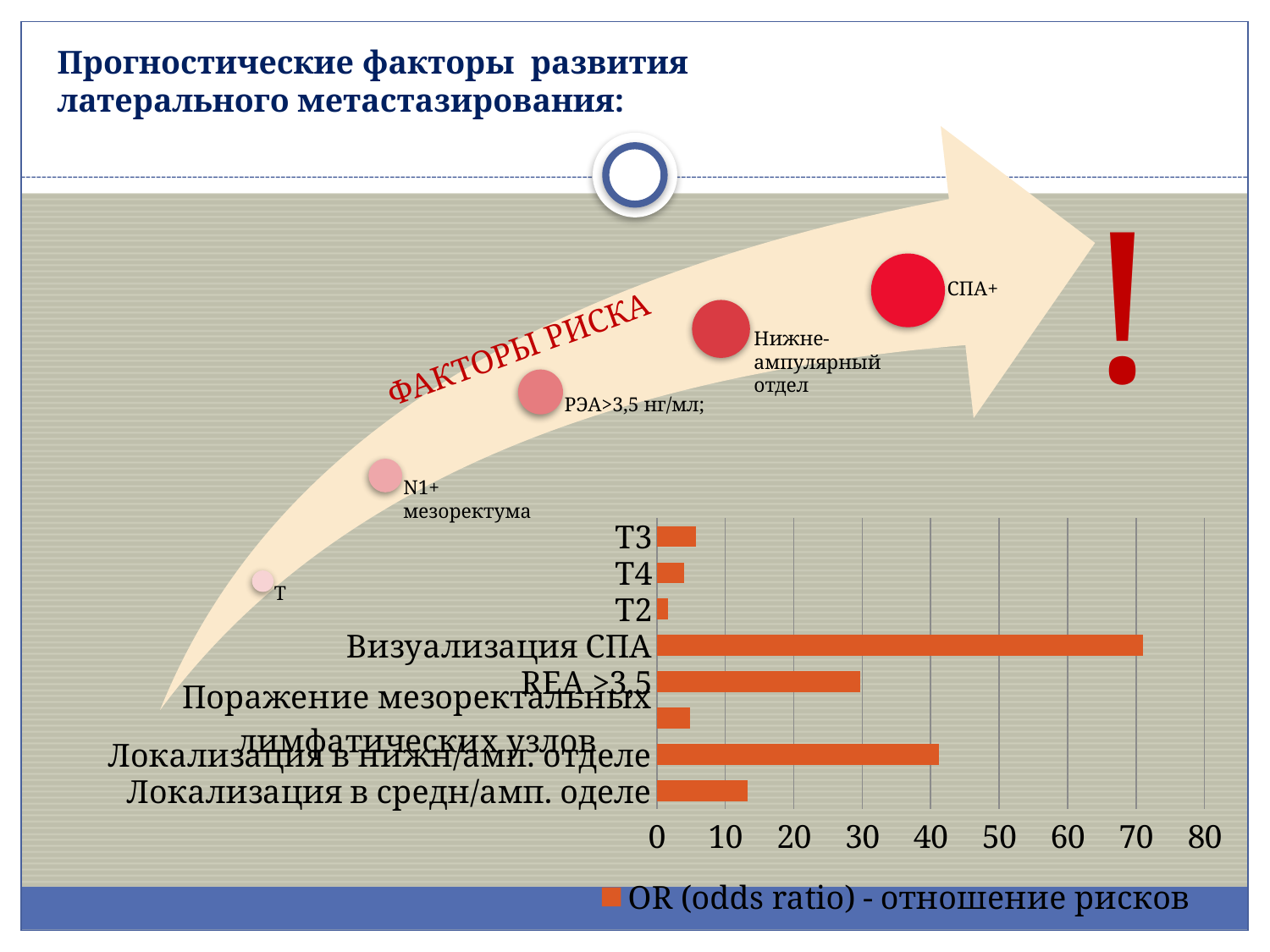
Which is larger in the bar chart: Визуализация СПА or Локализация в нижн/амп. отделе? Визуализация СПА What series name does the legend of the bar chart show? OR (odds ratio) - отношение рисков Is the value for Визуализация СПА greater or less than 60? greater Is the value for REA >3,5 greater or less than 40? less Is the value for Локализация в нижн/амп. отделе greater or less than 30? greater What kind of chart is shown on the slide? bar chart Which category has the lowest value in the bar chart? T2 How many series does the legend of the bar chart list? 1 Which category has the highest value in the bar chart? Визуализация СПА Which is larger in the bar chart: REA >3,5 or Локализация в средн/амп. оделе? REA >3,5 How many categories does the bar chart show? 8